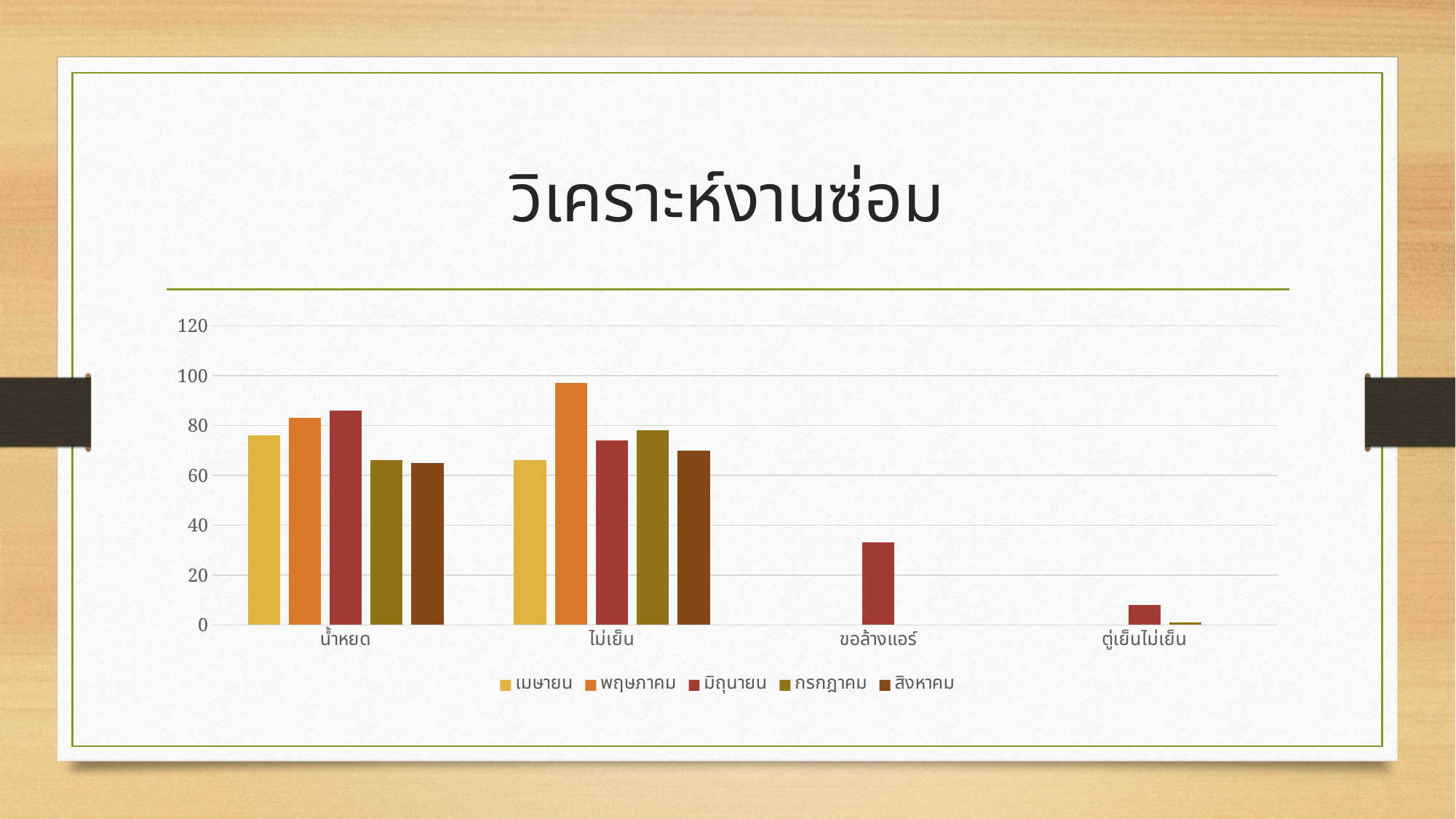
What kind of chart is shown on the slide? bar chart How many series does the legend list? 5 Which is larger: the มิถุนายน value for น้ำหยด or the มิถุนายน value for ขอล้างแอร์? น้ำหยด Which series is shown in the legend with the orange colour? พฤษภาคม Is the value for มิถุนายน in the ขอล้างแอร์ category greater or less than 40? less Which series has the tallest bar in the ไม่เย็น category? พฤษภาคม Which is larger in the ไม่เย็น category: พฤษภาคม or เมษายน? พฤษภาคม Is the value for เมษายน in the น้ำหยด category greater or less than 60? greater What is the title of the chart? วิเคราะห์งานซ่อม Which category has the lowest values overall? ตู่เย็นไม่เย็น Is the value for พฤษภาคม in the ไม่เย็น category greater or less than 80? greater How many categories are shown on the x axis? 4